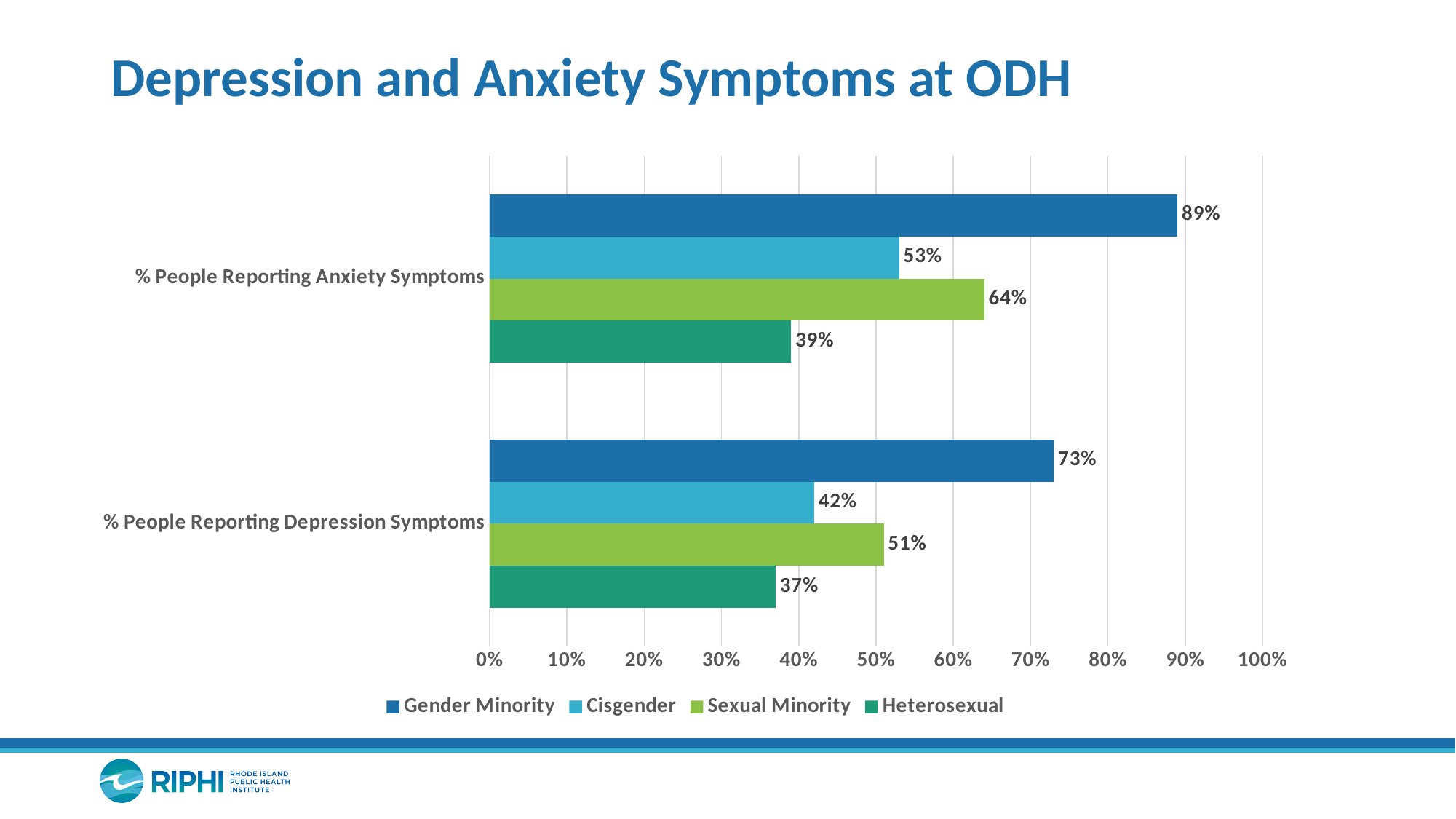
Which group has the highest percentage reporting depression symptoms? Gender Minority How many series does the legend list? 4 What percentage of Heterosexual people reported depression symptoms? 37% Which is larger: the Cisgender value for anxiety symptoms or the Sexual Minority value for depression symptoms? Cisgender value for anxiety symptoms What is the title of the slide? Depression and Anxiety Symptoms at ODH What is the value for Cisgender in the % People Reporting Depression Symptoms category? 42% What is the difference between the Gender Minority and Cisgender values for anxiety symptoms? 36% Which group has the lowest percentage reporting anxiety symptoms? Heterosexual What kind of chart is shown on the slide? Bar chart What is the value for Sexual Minority in the % People Reporting Anxiety Symptoms category? 64% What percentage of Gender Minority people reported anxiety symptoms? 89% What is the difference between the Sexual Minority and Heterosexual values for depression symptoms? 14%